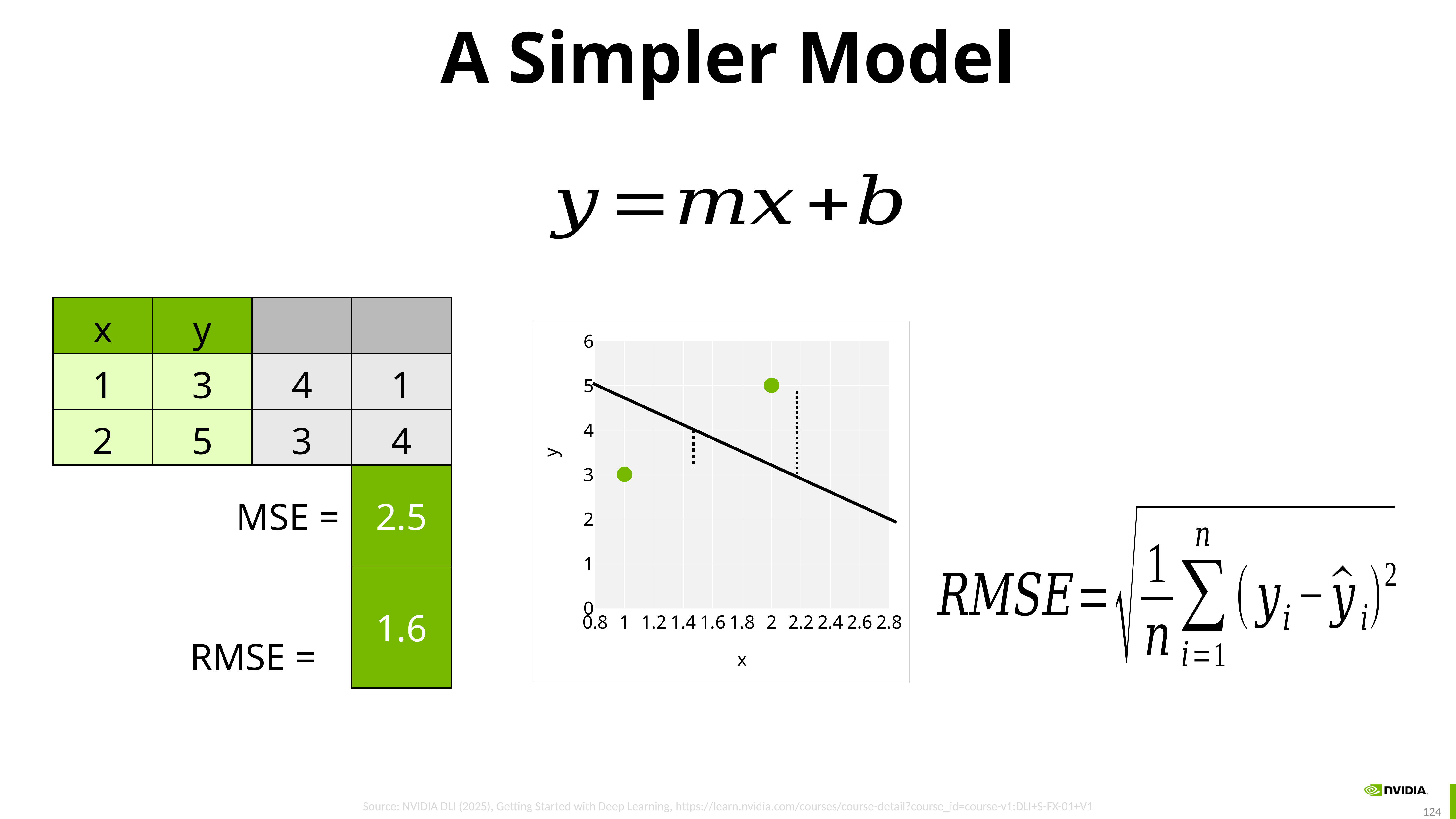
Which plotted point has the highest y value, the one at x = 1 or the one at x = 2? x = 2 What is the y value of the plotted point at x = 1? 3 How many data points are plotted in the chart? 2 What is the y value of the plotted point at x = 2? 5 What kind of chart is shown on the slide? scatter chart What is the label on the horizontal axis of the chart? x Is the value of the fitted line at x = 2 greater or less than 4? less Is the value of the fitted line at x = 1 greater or less than 4? greater Which plotted point has the lowest y value? the point at x = 1 What is the highest value shown on the vertical axis of the chart? 6 Do the plotted points rise or fall as x increases? rise What is the difference in y between the point at x = 2 and the point at x = 1? 2